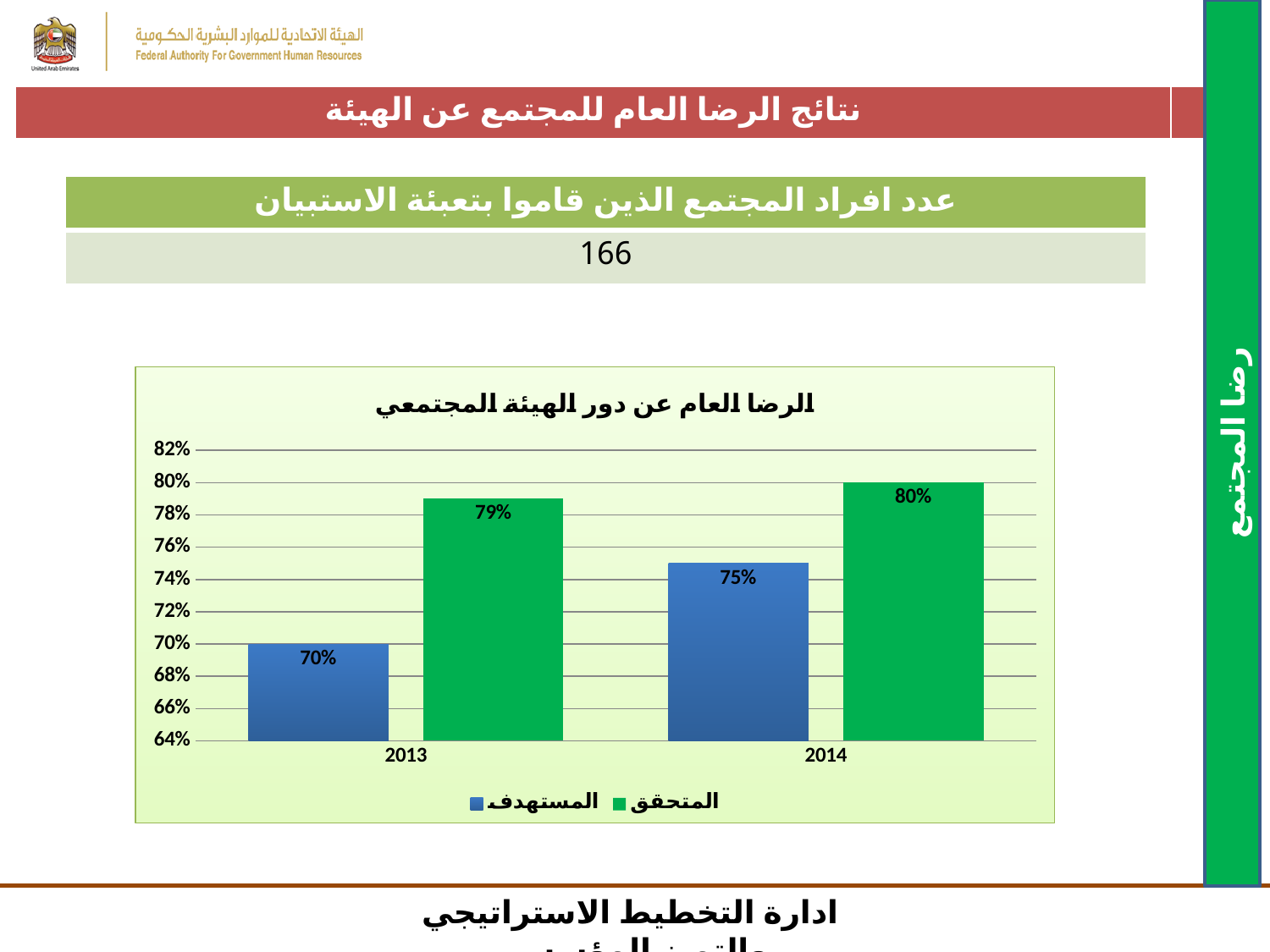
What is the difference between المتحقق and المستهدف in 2014? 5% Which year has the higher المتحقق (achieved) value? 2014 What is the value of المستهدف (target) for 2013? 70% What is the value of المتحقق (achieved) for 2013? 79% What type of chart is shown on the slide? bar chart What is the difference between المتحقق and المستهدف in 2013? 9% Does the المستهدف (target) value rise or fall from 2013 to 2014? rise Is المستهدف (target) for 2014 larger or smaller than المتحقق (achieved) for 2013? smaller What is the value of المتحقق (achieved) for 2014? 80% What is the value of المستهدف (target) for 2014? 75% Which bar has the lowest value in the chart? المستهدف for 2013 (70%) How many series does the legend list? 2